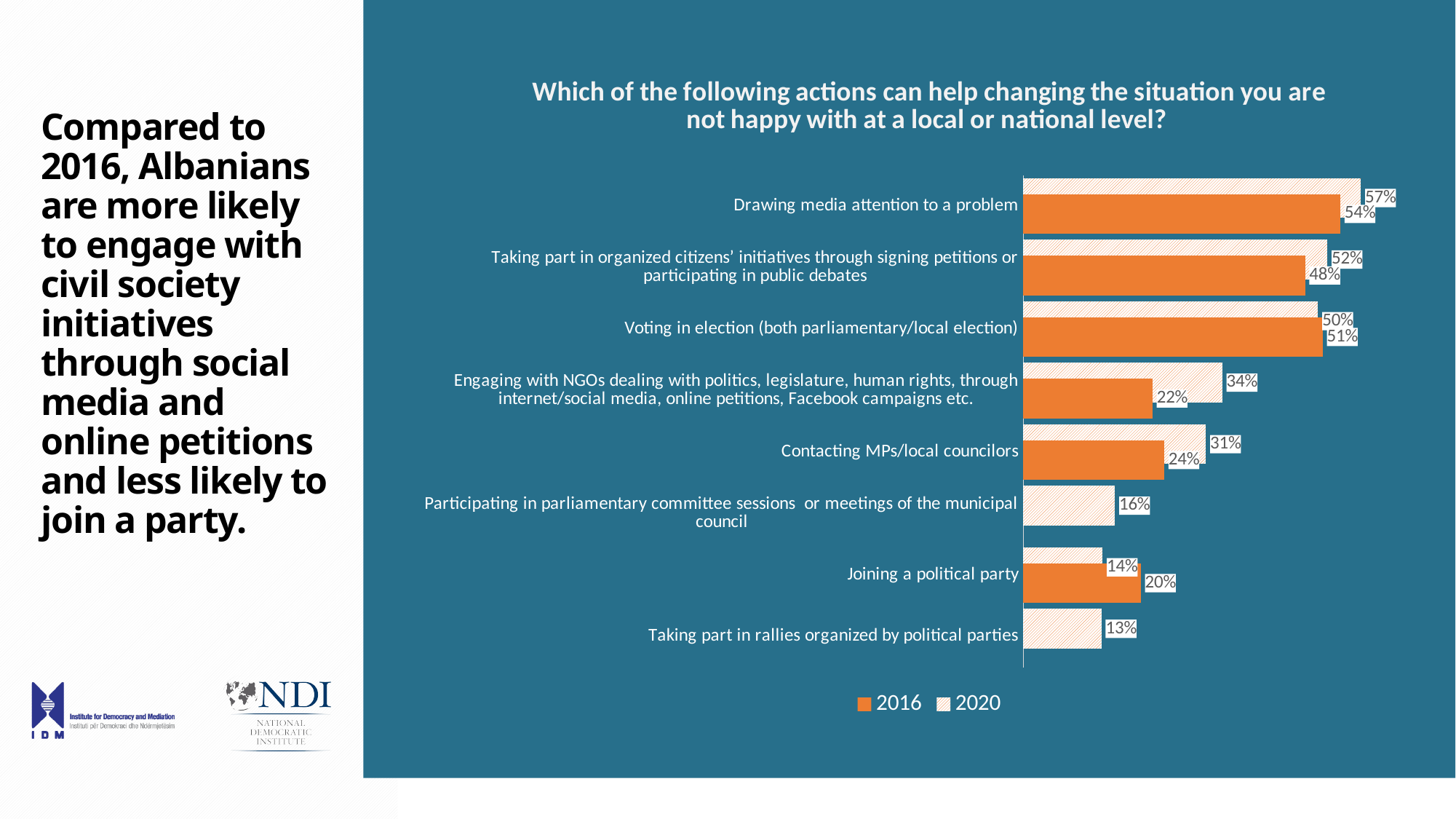
How many categories (actions) are shown in the chart? 8 What is the 2020 value for 'Engaging with NGOs dealing with politics, legislature, human rights, through internet/social media, online petitions, Facebook campaigns etc.'? 34% For 'Joining a political party', which year has the larger value, 2016 or 2020? 2016 How many series does the legend list? 2 Which action has the highest 2020 value? Drawing media attention to a problem Which action has the lowest 2020 value? Taking part in rallies organized by political parties Which series is shown with solid orange bars in the legend? 2016 What is the 2016 value for 'Joining a political party'? 20% What type of chart is shown on the slide? bar chart What is the difference between the 2020 and 2016 values for 'Engaging with NGOs dealing with politics, legislature, human rights, through internet/social media, online petitions, Facebook campaigns etc.'? 12% What is the 2016 value for 'Contacting MPs/local councilors'? 24% What is the 2020 value for 'Drawing media attention to a problem'? 57%